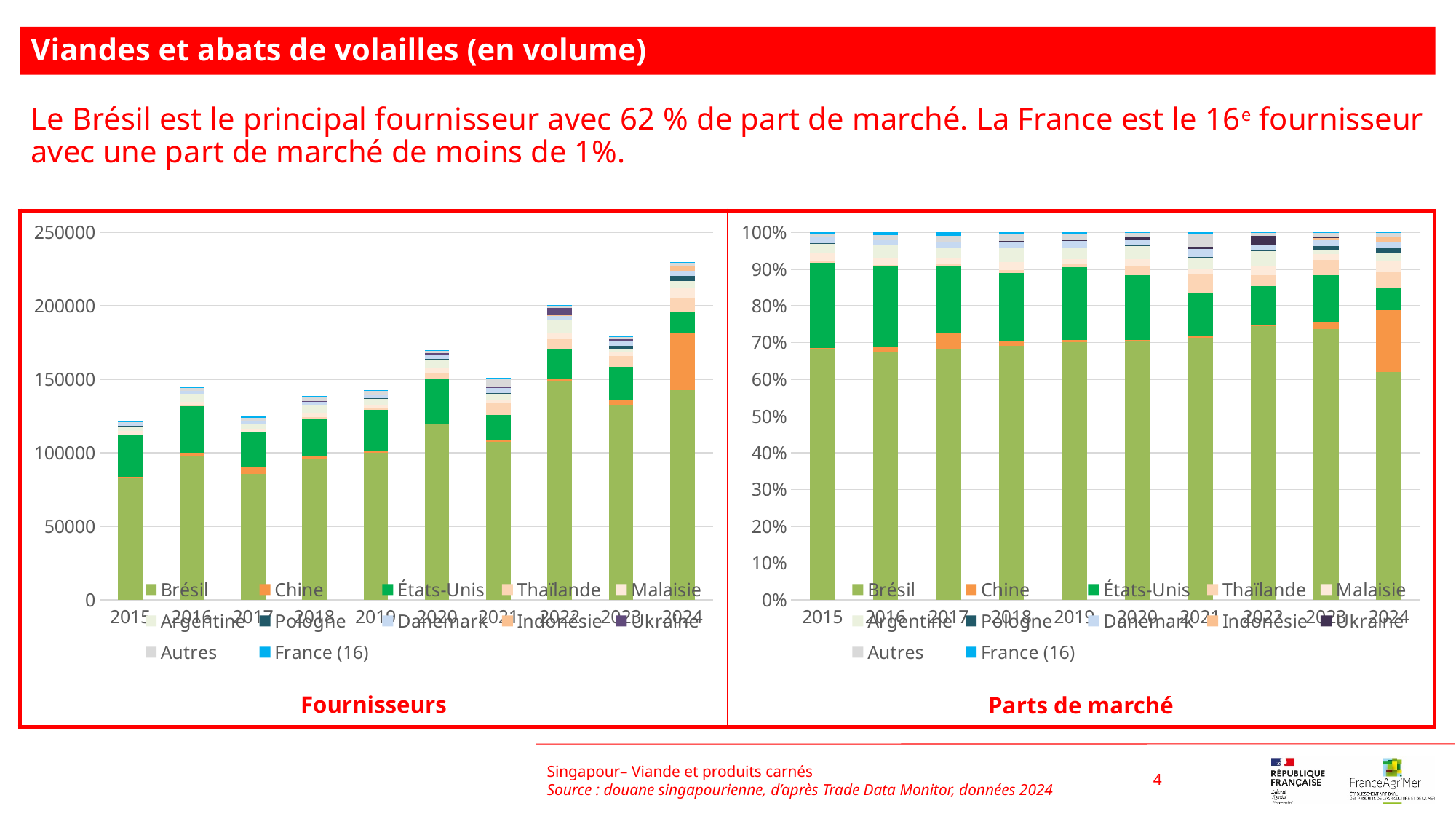
In the 'Fournisseurs' chart, is the total bar for 2022 larger or smaller than the total bar for 2021? larger In the 'Fournisseurs' chart, which year has the highest total bar? 2024 Which series is shown at the bottom of each stacked bar in both charts? Brésil In the 'Fournisseurs' chart, is the total for 2015 greater or less than 150000? less What kind of chart is the 'Fournisseurs' chart on the left? Stacked bar chart In the 'Parts de marché' chart, which year has the lowest share for Brésil? 2024 In the 'Parts de marché' chart, is the share of Brésil in 2024 greater or less than 60%? greater How many series does the legend of the 'Fournisseurs' chart list? 12 In the 'Fournisseurs' chart, is the total for 2024 greater or less than 200000? greater In the 'Parts de marché' chart, is the share of Brésil larger in 2015 or in 2024? 2015 How many years are shown on the x axis of the 'Parts de marché' chart? 10